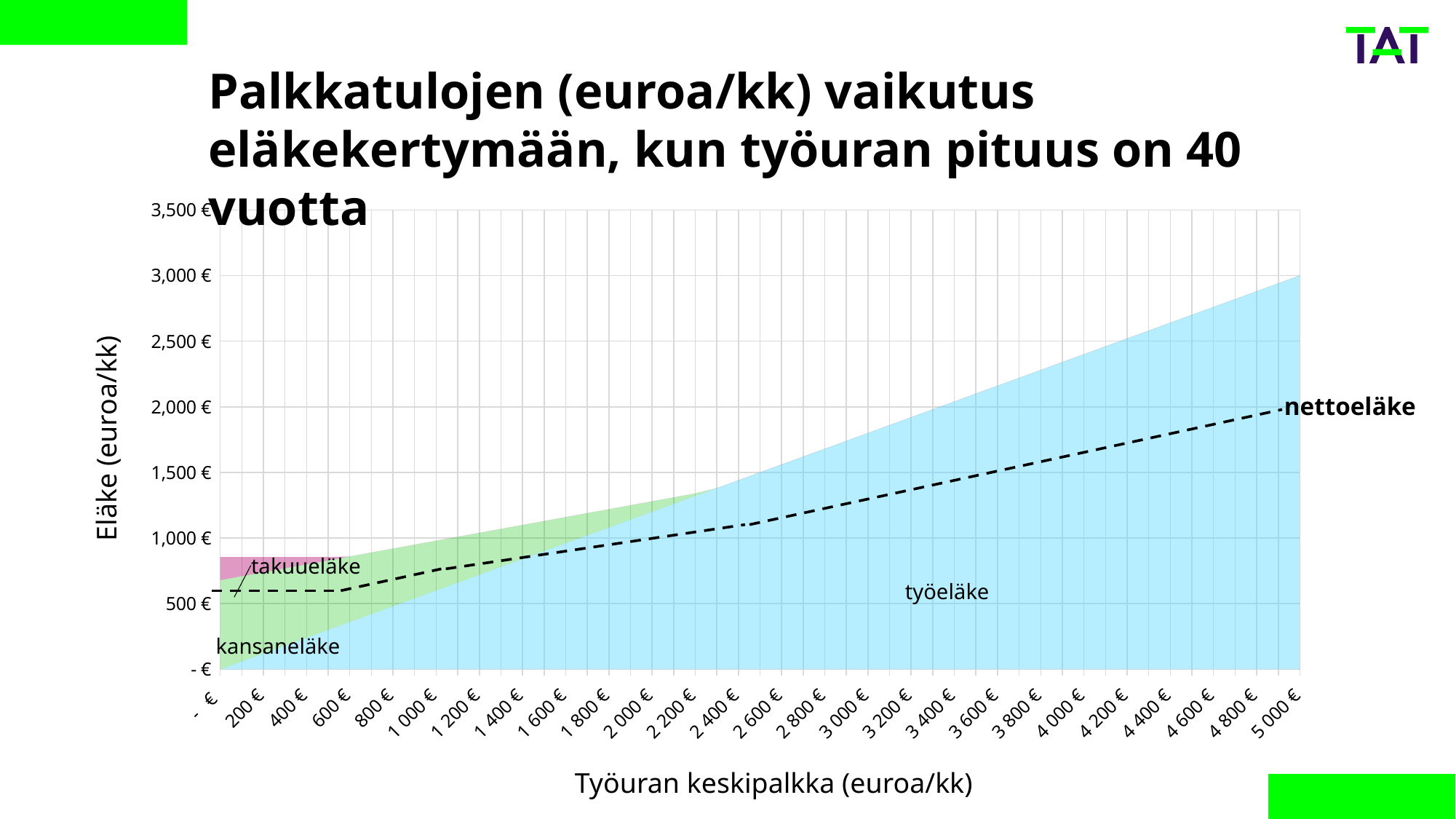
How many labelled series (areas and lines) are shown in the chart? 4 Does the työeläke area grow or shrink as the average salary increases along the x axis? Grows Does the nettoeläke line rise or fall as the average salary increases along the x axis? Rises What is the title of the chart? Palkkatulojen (euroa/kk) vaikutus eläkekertymään, kun työuran pituus on 40 vuotta Is the value of nettoeläke at 2 000 € greater or less than 1,500 €? less Is the value of nettoeläke at 0 € (- €) greater or less than 1,000 €? less What is the label of the x axis? Työuran keskipalkka (euroa/kk) Is the top of the työeläke area at 5 000 € greater or less than 2,500 €? greater What kind of chart is shown on the slide? Area chart with a dashed line At 5 000 € average salary, which is larger: the top of the työeläke area or the nettoeläke line? työeläke Which series is drawn as a dashed line? nettoeläke